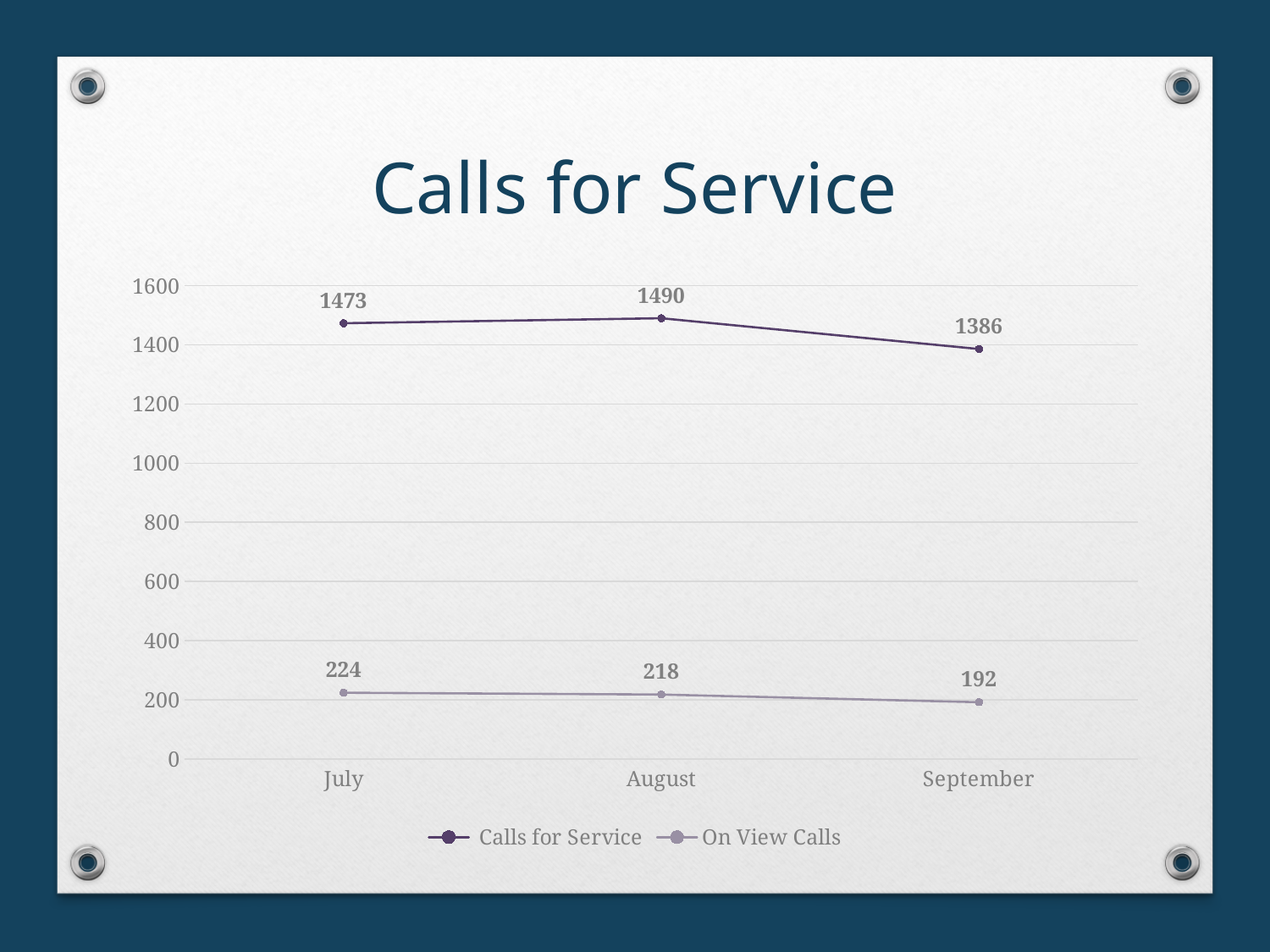
What is the value for Calls for Service in August? 1490 How many series does the legend list? 2 In which month is Calls for Service highest? August Which is larger: On View Calls in July or On View Calls in August? July How many months are shown on the x axis? 3 What is the value for Calls for Service in July? 1473 What is the value for On View Calls in September? 192 What kind of chart is shown on the slide? Line chart Does On View Calls rise or fall from August to September? Fall In which month is On View Calls lowest? September What is the difference between Calls for Service in August and September? 104 What is the difference between On View Calls in July and September? 32